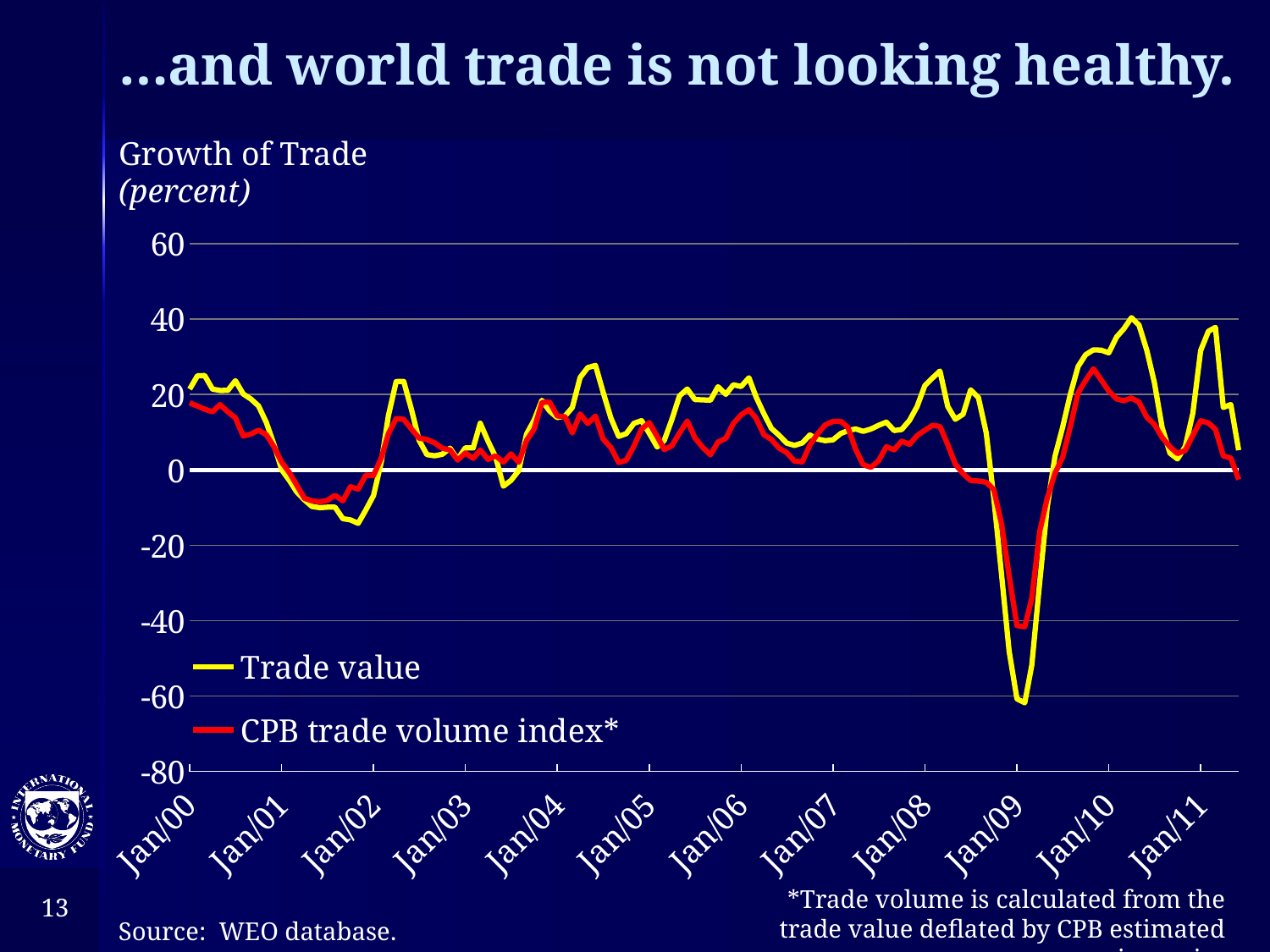
From its peak in early 2010 to the end of the series in 2011, does the Trade value series rise or fall overall? fall What kind of chart is shown on the slide? line chart Is the peak of the Trade value series around early 2010 greater or less than 20? greater How many year labels are shown on the x axis? 12 What are the two series named in the legend? Trade value; CPB trade volume index* Is the lowest value of the CPB trade volume index series, around Jan/09, greater or less than -20? less At the trough around Jan/09, which series falls lower: Trade value or CPB trade volume index? Trade value Between Jan/00 and Jan/01, does the CPB trade volume index rise or fall? fall Is the Trade value at Jan/00 greater or less than 0? greater What is the title of the chart? Growth of Trade (percent) How many series does the legend list? 2